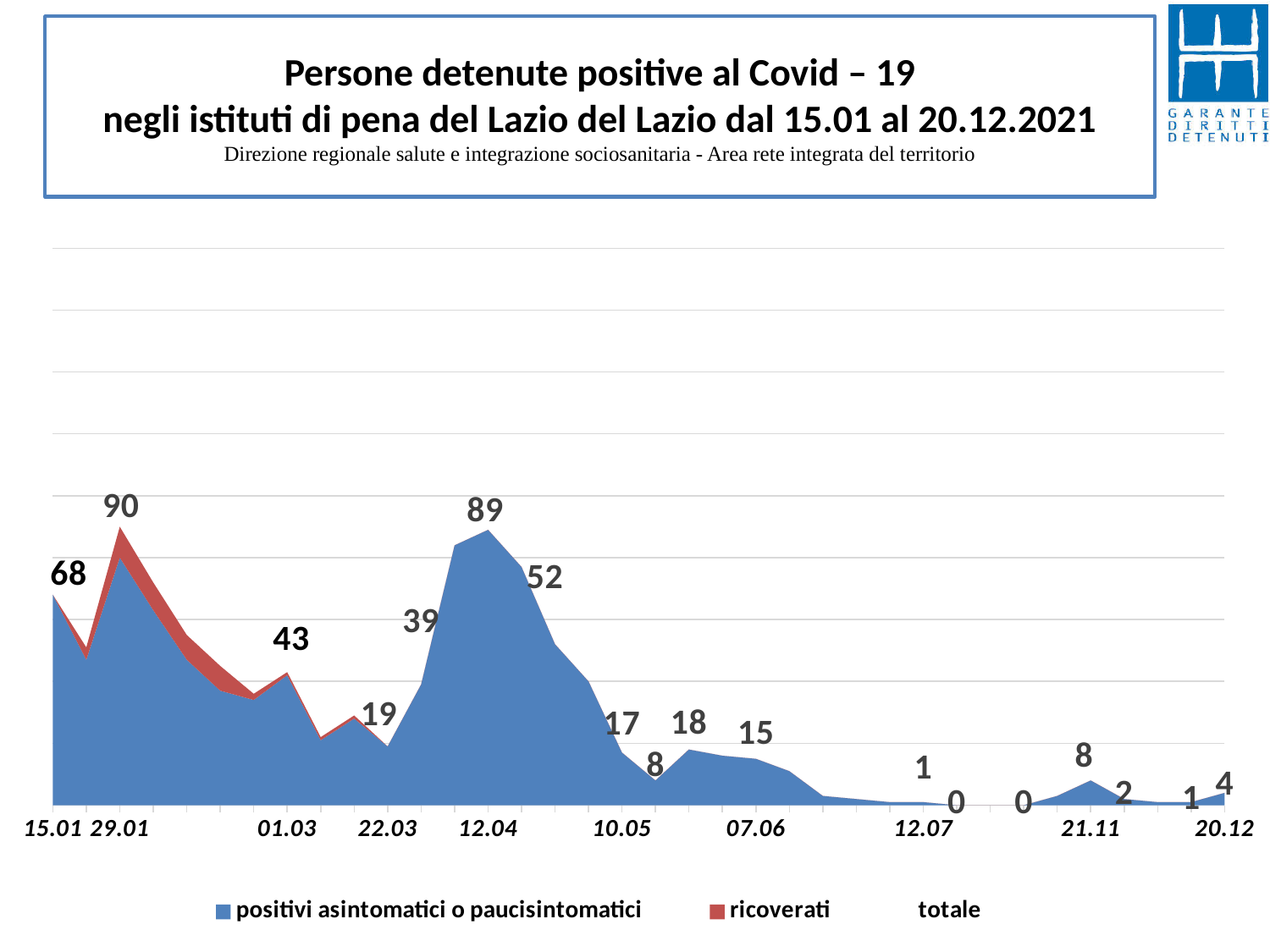
What is the value labelled at 01.03? 43 What is the difference between the values labelled at 29.01 and 12.04? 1 On which date does the chart reach its highest labelled value? 29.01 How many series does the legend list? 3 Which series is shown in red in the legend? ricoverati What is the value labelled at 15.01? 68 What is the value labelled at 12.04? 89 What is the value labelled at 29.01? 90 What type of chart is shown on the slide? area chart What is the value labelled at 20.12? 4 Which is larger, the value at 15.01 or the value at 01.03? 15.01 Do the values rise or fall between 12.04 and 12.07? fall